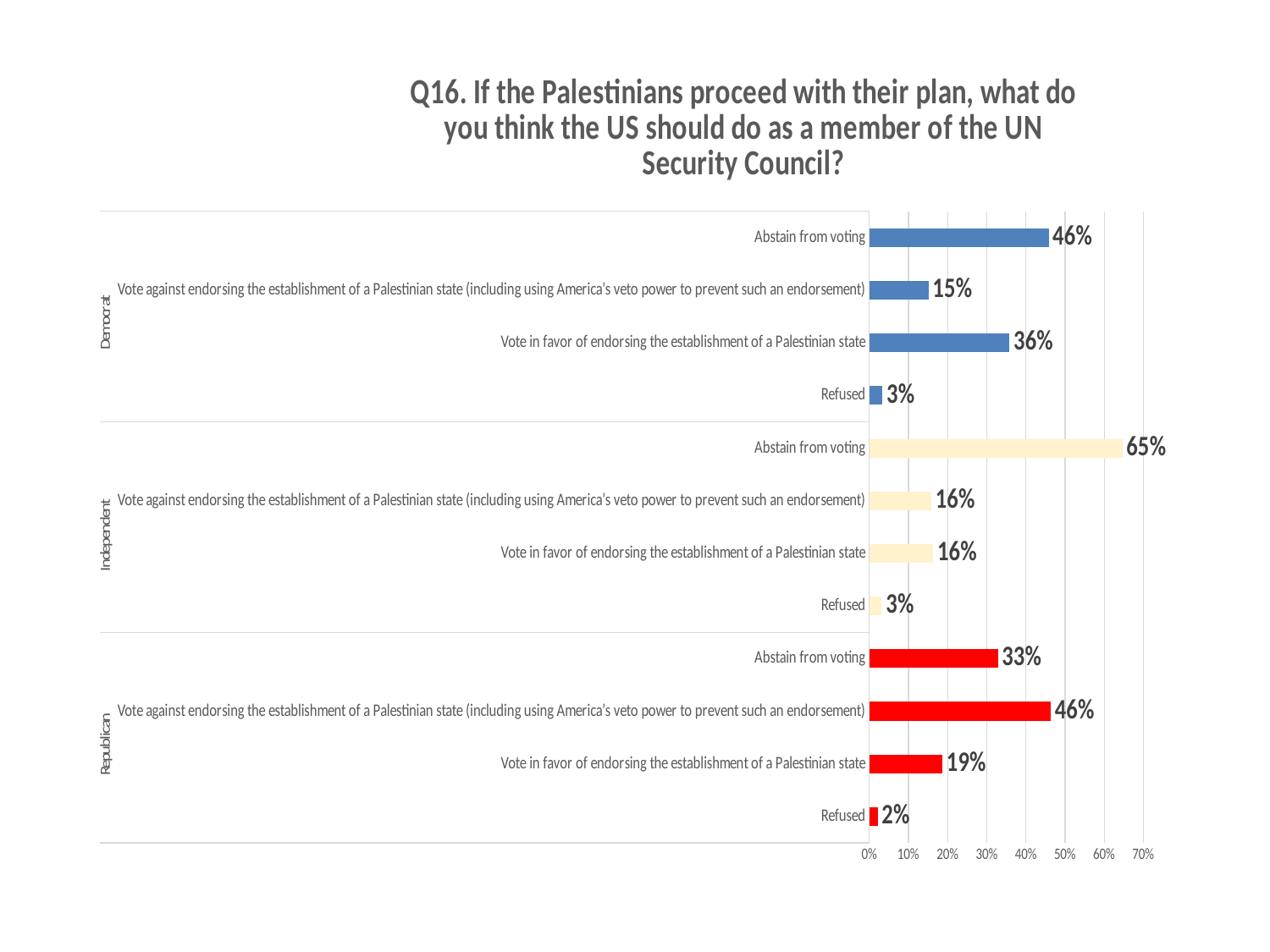
What percentage of Republicans say the US should vote against endorsing the establishment of a Palestinian state? 46% How many party groups are shown on the chart? 3 What kind of chart is shown on the slide? Bar chart Which group has a larger share saying the US should abstain from voting, Democrats or Republicans? Democrats Which response has the lowest value among Democrats? Refused Which response has the highest value among Republicans? Vote against endorsing the establishment of a Palestinian state (including using America's veto power to prevent such an endorsement) What percentage of Independents say the US should abstain from voting? 65% What percentage of Democrats say the US should abstain from voting? 46% Is the Independent value for abstaining from voting greater or less than 60%? greater What is the difference between the Democrat and Republican percentages for voting in favor of endorsing the establishment of a Palestinian state? 17% What percentage of Republicans refused to answer? 2% What colour are the bars for the Republican group? Red